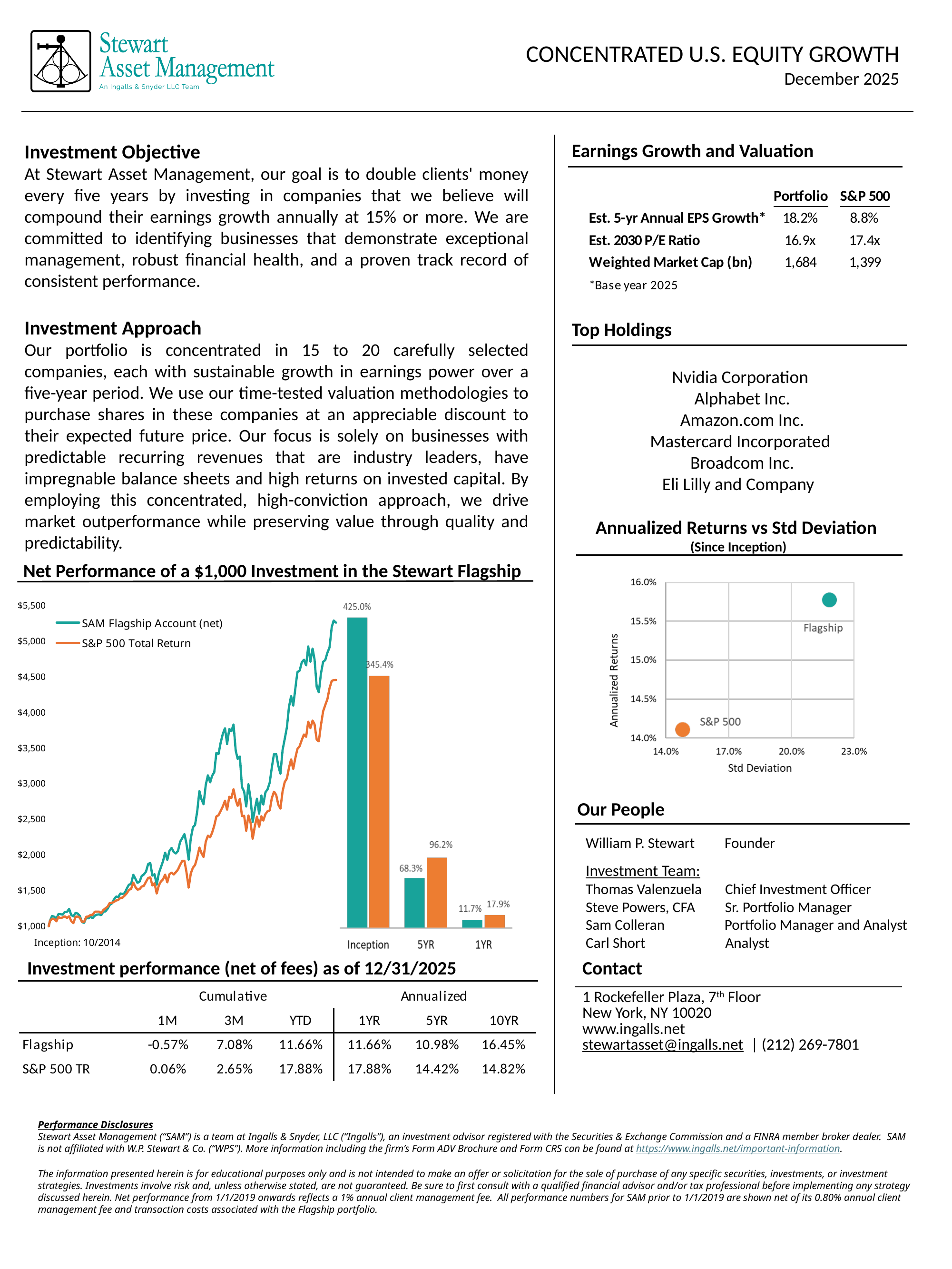
How many series does the legend of the Net Performance of a $1,000 Investment chart list? 2 In the bar chart within the Net Performance of a $1,000 Investment chart, which series has the larger 5YR value, SAM Flagship Account (net) or S&P 500 Total Return? S&P 500 Total Return In the bar chart within the Net Performance of a $1,000 Investment chart, what is the 5YR value for the S&P 500 Total Return? 96.2% In the bar chart within the Net Performance of a $1,000 Investment chart, what is the Inception value for the SAM Flagship Account (net)? 425.0% In the bar chart within the Net Performance of a $1,000 Investment chart, what is the difference between the Inception values for the SAM Flagship Account (net) and the S&P 500 Total Return? 79.6% In the bar chart within the Net Performance of a $1,000 Investment chart, what is the 1YR value for the SAM Flagship Account (net)? 11.7% What kind of chart is the Annualized Returns vs Std Deviation chart? Scatter chart In the Annualized Returns vs Std Deviation chart, is the std deviation for S&P 500 greater or less than 17.0%? less In the Annualized Returns vs Std Deviation chart, is the annualized return for Flagship greater or less than 15.5%? greater In the Net Performance of a $1,000 Investment chart, do the line values generally rise or fall from inception to the end of the period? Rise In the bar chart within the Net Performance of a $1,000 Investment chart, which period has the lowest value for the S&P 500 Total Return? 1YR In the bar chart within the Net Performance of a $1,000 Investment chart, how many periods are shown on the x axis? 3